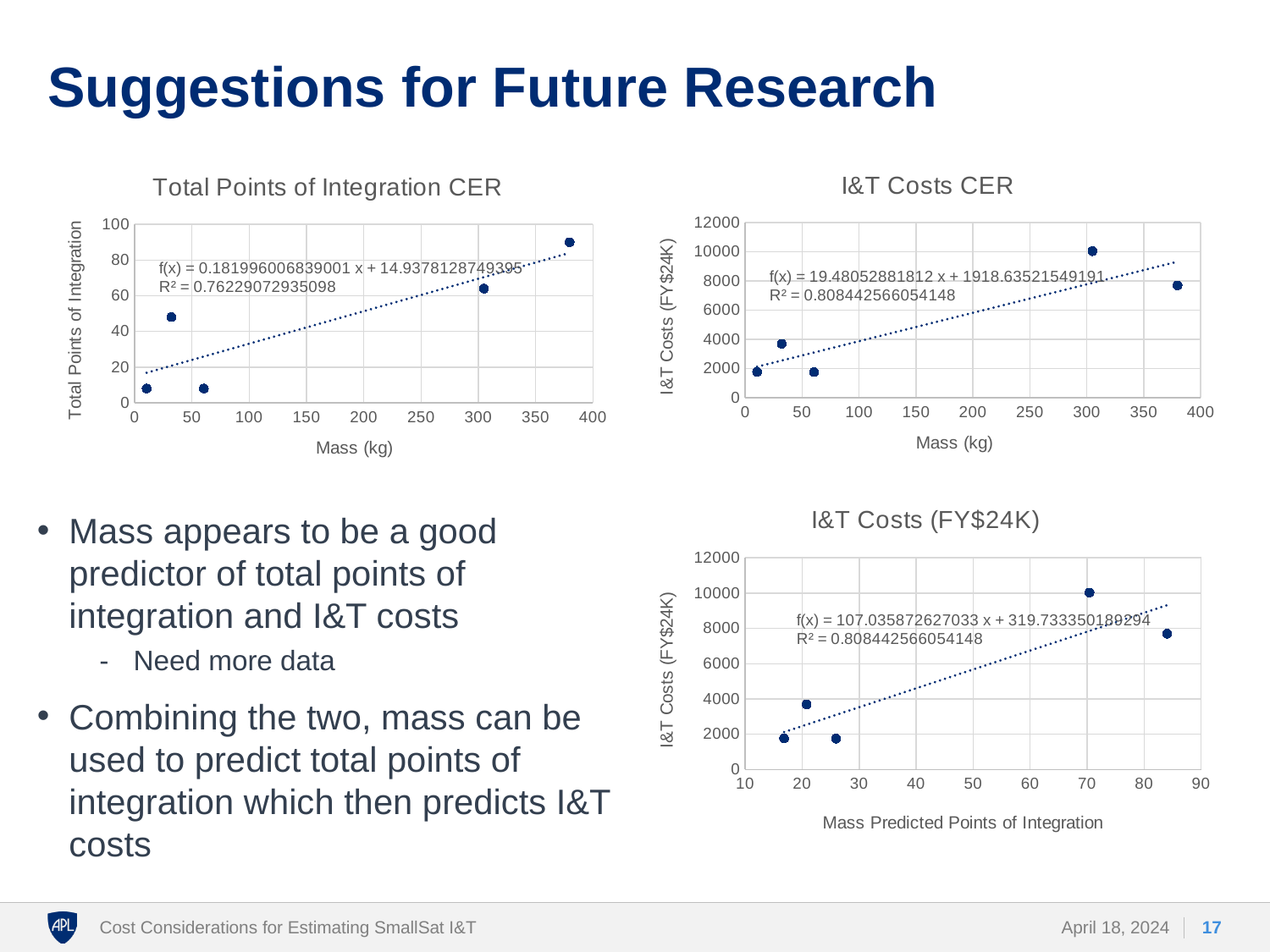
In the "Total Points of Integration CER" chart, do the total points of integration generally rise or fall as mass increases? rise In the "I&T Costs (FY$24K)" chart, is the I&T cost for the point at roughly 70 predicted points of integration greater or less than 8000? greater What kind of chart is the "Total Points of Integration CER" chart? scatter chart What is the x-axis label of the "I&T Costs (FY$24K)" chart at the bottom right? Mass Predicted Points of Integration How many data points are plotted in the "Total Points of Integration CER" chart? 5 How many data points are plotted in the "I&T Costs CER" chart? 5 What R² value is shown on the "Total Points of Integration CER" chart? 0.76229072935098 In the "I&T Costs CER" chart, is the I&T cost for the point at roughly 60 kg greater or less than 4000? less How many data points are plotted in the "I&T Costs (FY$24K)" chart? 5 In the "Total Points of Integration CER" chart, is the value for the point at the highest mass greater or less than 80? greater In the "I&T Costs CER" chart, do I&T costs generally rise or fall as mass increases? rise